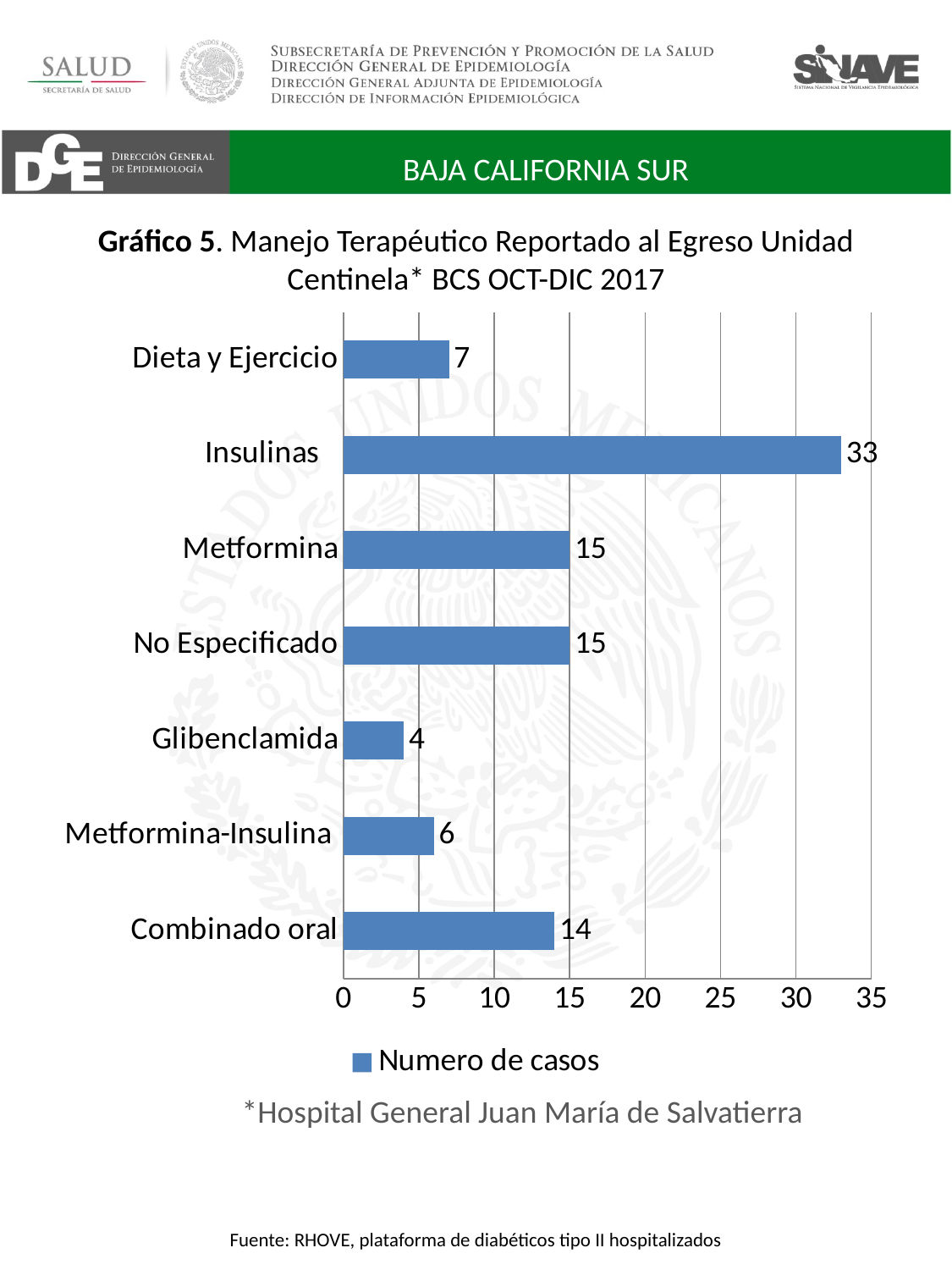
Which category has the lowest number of cases? Glibenclamida What is the difference in number of cases between Insulinas and Metformina? 18 What is the number of cases for Glibenclamida? 4 Which category has the highest number of cases? Insulinas What is the number of cases for Combinado oral? 14 What kind of chart is shown on the slide? Bar chart Is the value for Combinado oral greater or less than 10? greater What is the legend entry of the chart? Numero de casos How many series does the legend list? 1 What is the number of cases for Insulinas? 33 Which has more cases, Dieta y Ejercicio or Metformina-Insulina? Dieta y Ejercicio How many categories are shown on the chart? 7